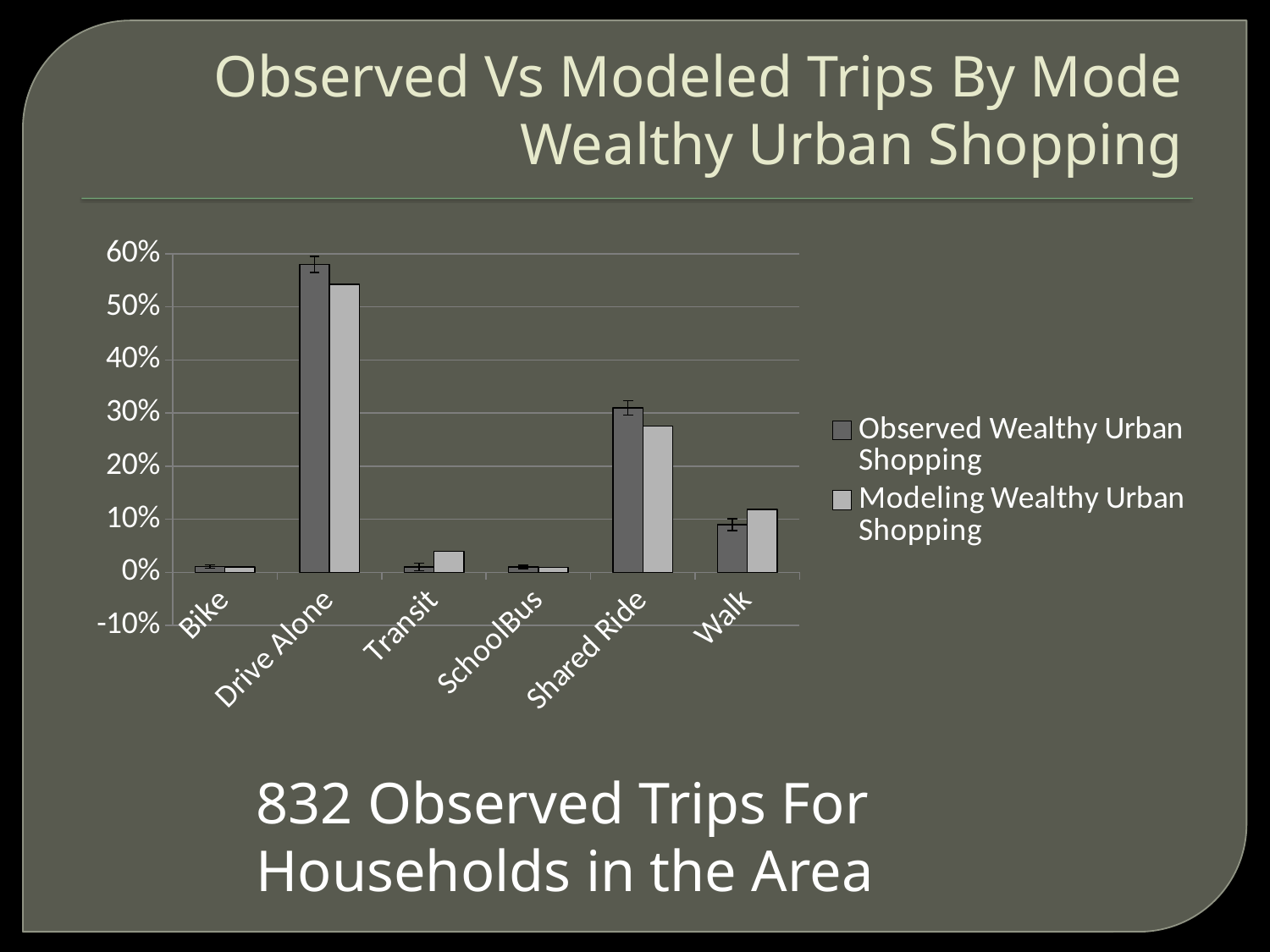
How many series does the legend list? 2 How many trip mode categories are shown on the x axis? 6 Is the Modeling Wealthy Urban Shopping value for Shared Ride greater or less than 30%? less Which mode has the highest value for Observed Wealthy Urban Shopping? Drive Alone What kind of chart is shown on the slide? bar chart For Walk, which series has the larger value: Observed Wealthy Urban Shopping or Modeling Wealthy Urban Shopping? Modeling Wealthy Urban Shopping What is the title of the slide containing the chart? Observed Vs Modeled Trips By Mode Wealthy Urban Shopping Which mode has the highest value for Modeling Wealthy Urban Shopping? Drive Alone Is the Modeling Wealthy Urban Shopping value for Walk greater or less than 10%? greater Is the Observed Wealthy Urban Shopping value for Drive Alone greater or less than 50%? greater For Drive Alone, which series has the larger value: Observed Wealthy Urban Shopping or Modeling Wealthy Urban Shopping? Observed Wealthy Urban Shopping